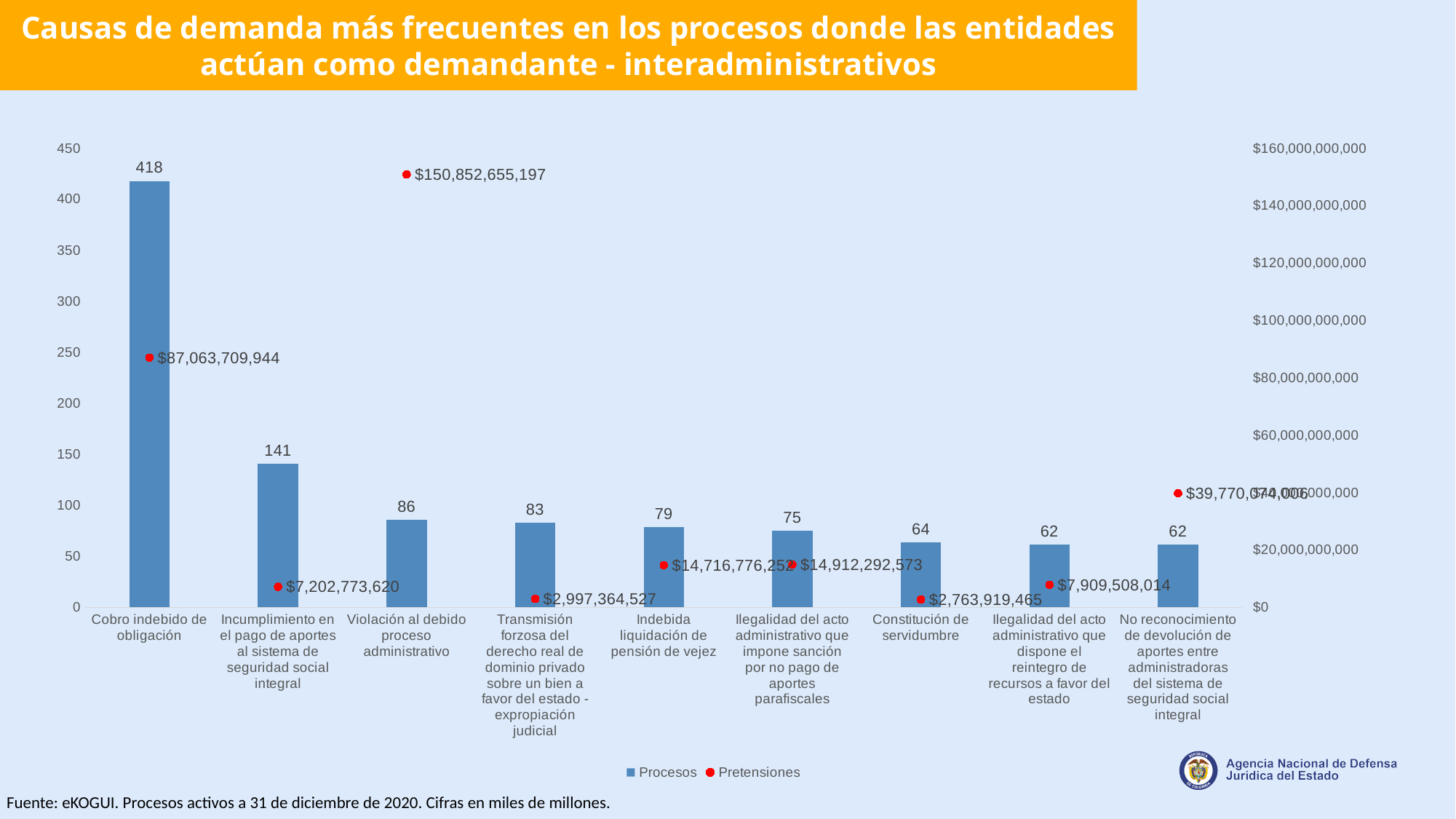
Which category has the highest Pretensiones value? Violación al debido proceso administrativo Do the Procesos values rise or fall from left to right along the x axis? fall Is the number of Procesos for 'Incumplimiento en el pago de aportes al sistema de seguridad social integral' greater or less than 100? greater What is the Pretensiones value for 'Constitución de servidumbre'? $2,763,919,465 How many Procesos are shown for 'Cobro indebido de obligación'? 418 Which has more Procesos: 'Indebida liquidación de pensión de vejez' or 'Ilegalidad del acto administrativo que impone sanción por no pago de aportes parafiscales'? Indebida liquidación de pensión de vejez How many categories are shown on the x axis of the chart? 9 What is the Pretensiones value for 'Violación al debido proceso administrativo'? $150,852,655,197 What is the difference in Procesos between 'Cobro indebido de obligación' and 'Incumplimiento en el pago de aportes al sistema de seguridad social integral'? 277 What kind of chart is used to show the Procesos series? bar chart How many series does the legend list? 2 Which category has the highest number of Procesos? Cobro indebido de obligación